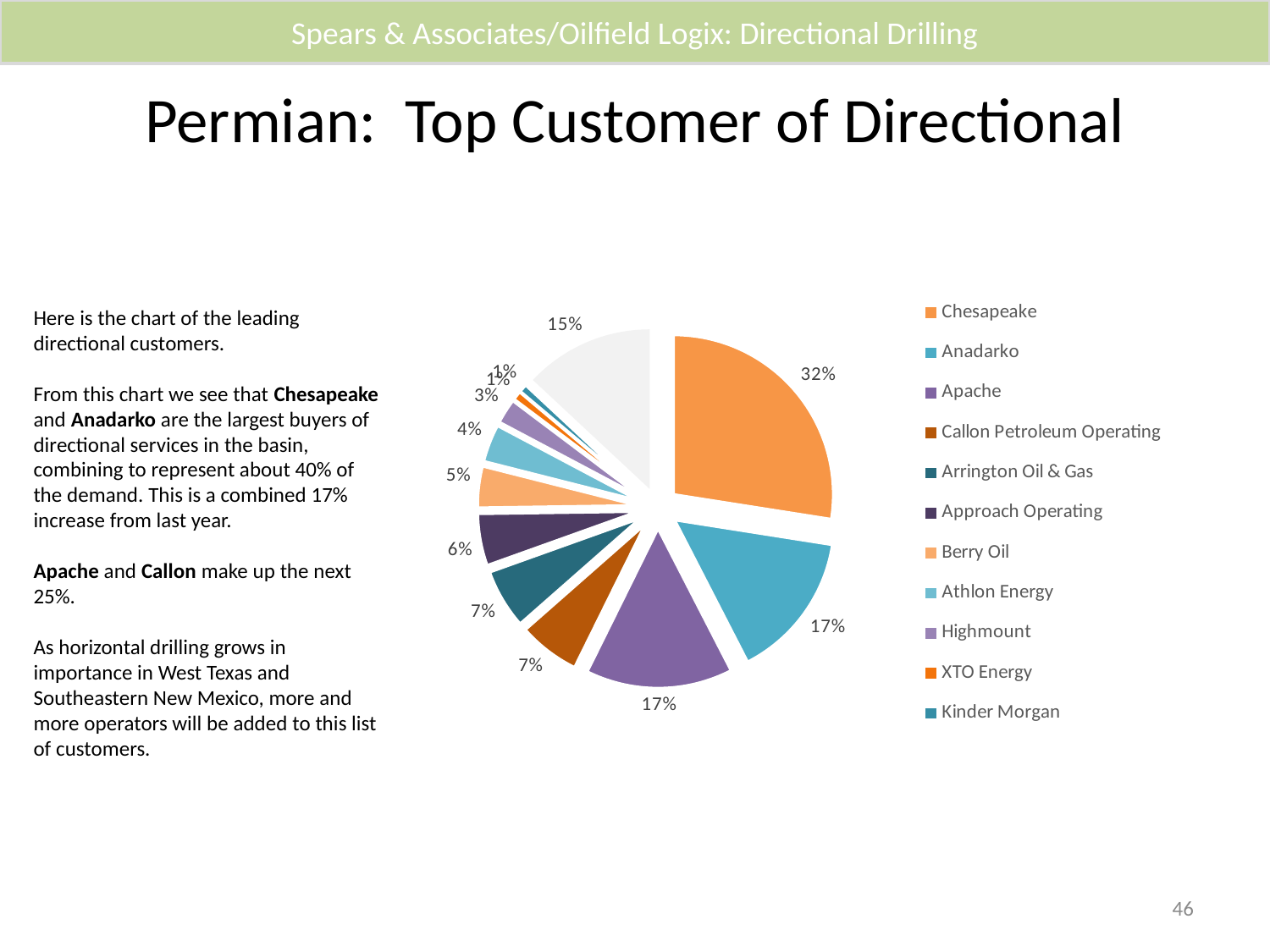
What share of the pie does Berry Oil represent? 5% What kind of chart is shown on the slide? Pie chart What percentage is shown for Anadarko? 17% What share does Callon Petroleum Operating have in the pie chart? 7% How many customers are listed in the chart's legend? 11 What percentage is shown for Athlon Energy? 4% Which has the larger share, Berry Oil or Athlon Energy? Berry Oil How many percentage points larger is Chesapeake's share than Anadarko's? 15 percentage points What percentage is labelled for Approach Operating? 6% Which customer has the largest slice of the pie? Chesapeake What share of the pie does Chesapeake hold? 32% What percentage is shown for Apache? 17%